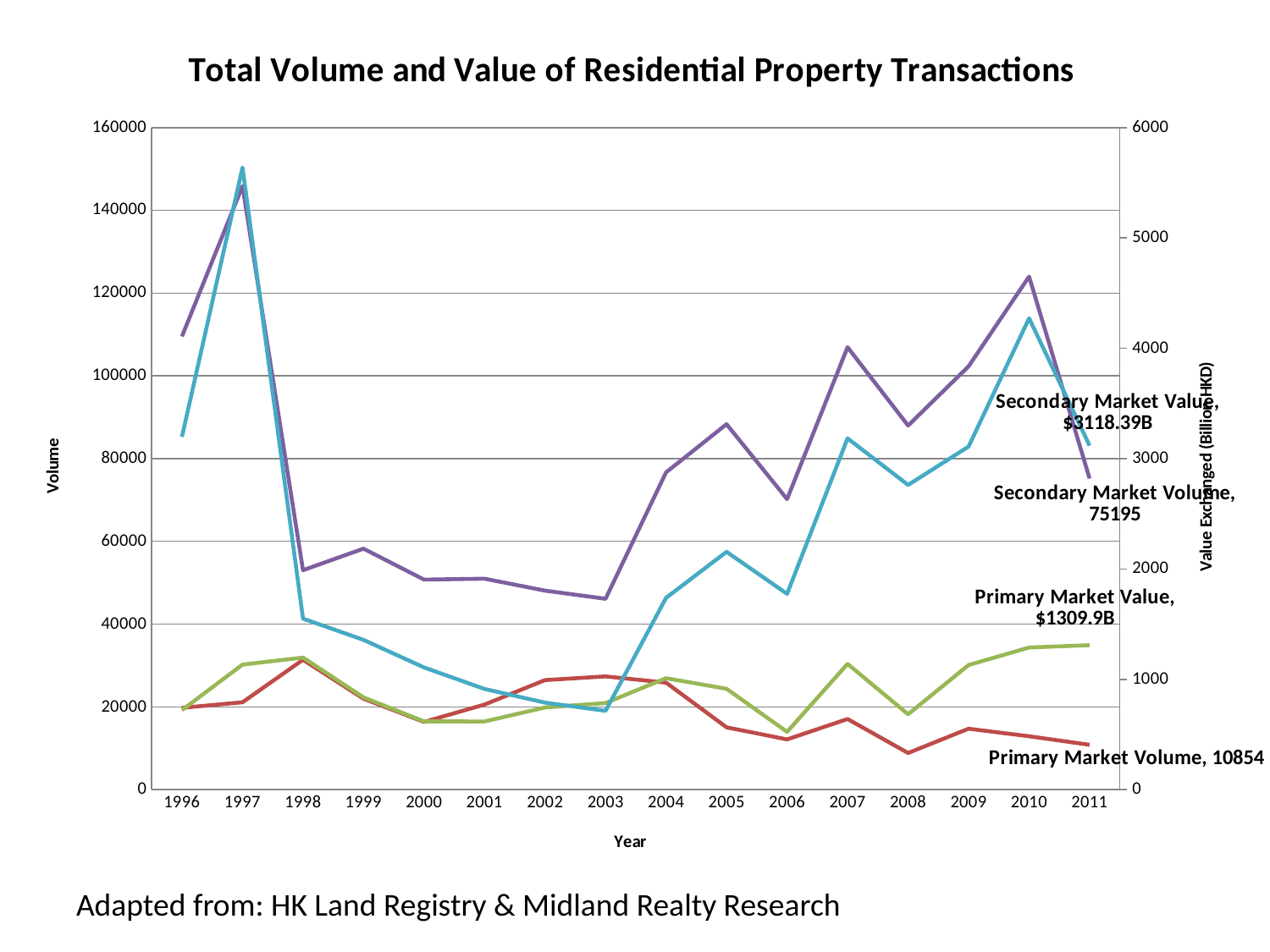
How many years are plotted along the x axis? 16 In 2011, which is larger, the Secondary Market Volume or the Primary Market Volume? Secondary Market Volume In which year does the Secondary Market Volume reach its highest point? 1997 What is the difference between the Secondary Market Volume and the Primary Market Volume in 2011? 64341 What kind of chart is shown on the slide? line chart What is the Primary Market Volume in 2011? 10854 Is the Secondary Market Volume in 1997 greater or less than 140000? greater Is the Secondary Market Volume in 1998 greater or less than 60000? less What is the Secondary Market Volume in 2011? 75195 Does the Secondary Market Volume rise or fall from 2007 to 2008? fall What is the Secondary Market Value in 2011? $3118.39B What is the Primary Market Value in 2011? $1309.9B